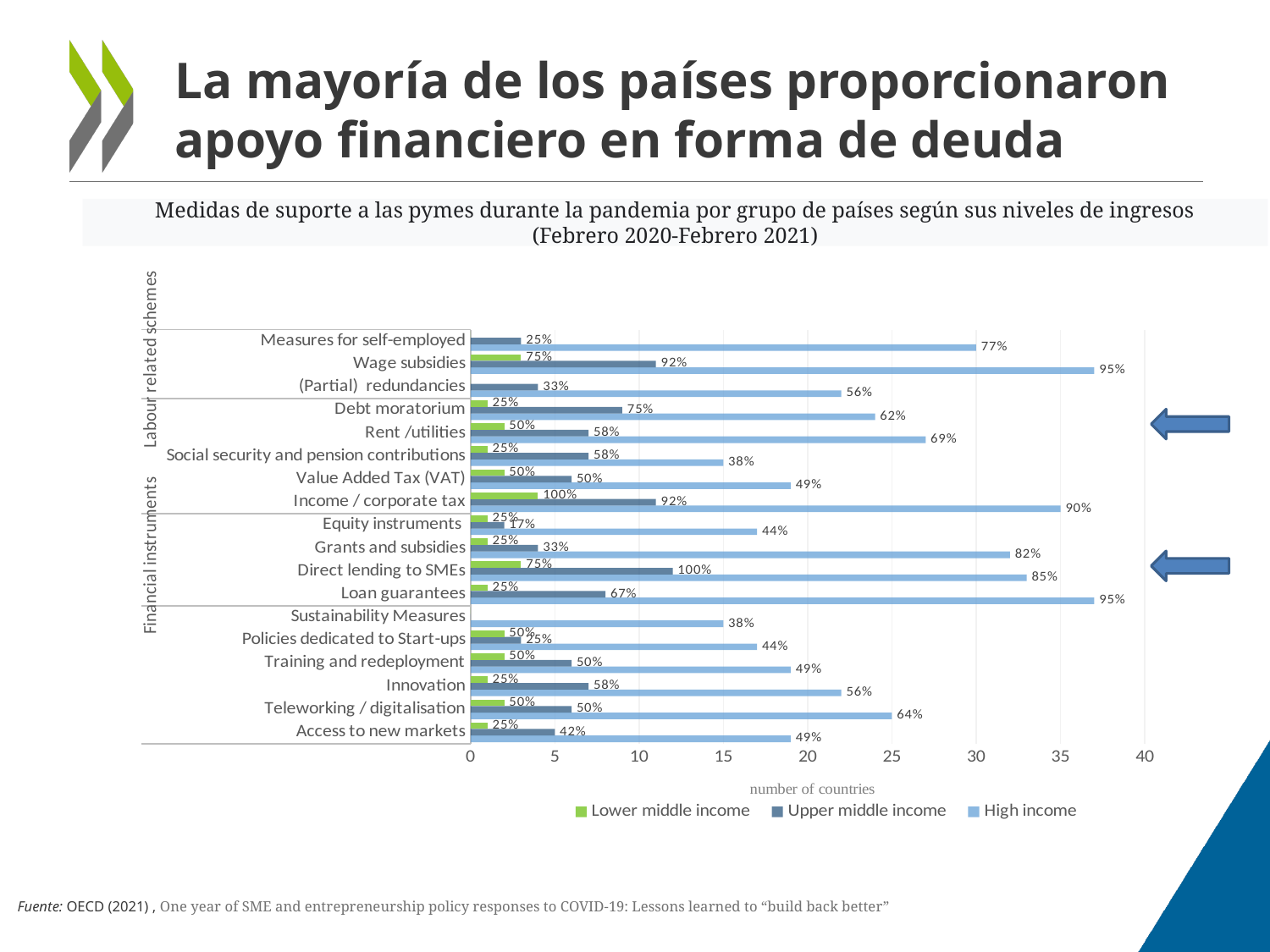
How many series does the legend list? 3 What is the Upper middle income value for Direct lending to SMEs? 100% What label is shown on the horizontal axis of the chart? number of countries What is the High income value for Loan guarantees? 95% How many support measure categories are listed on the vertical axis of the chart? 18 What type of chart is shown on the slide? bar chart What is the Lower middle income value for Income / corporate tax? 100% Which category has the highest Upper middle income value? Direct lending to SMEs What is the difference between the High income and Upper middle income values for Loan guarantees? 28 percentage points What is the High income value for Grants and subsidies? 82% Which category has the lowest Upper middle income value? Sustainability Measures